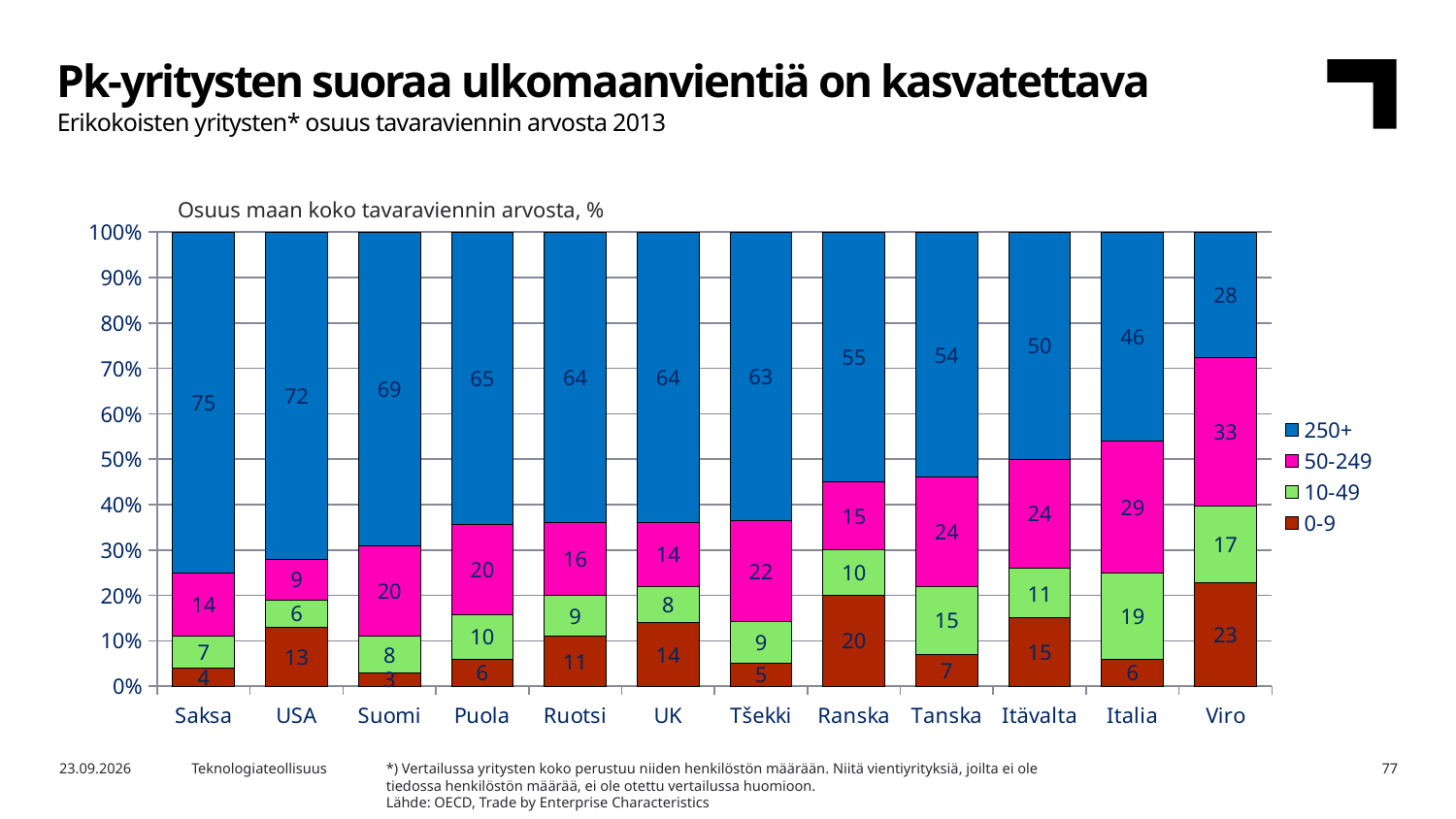
What is the value of the 0-9 series for Viro? 23 What is the value of the 250+ series for Saksa? 75 What is the value of the 10-49 series for Tanska? 15 How many countries are shown on the x axis? 12 Which country has the lowest value for the 0-9 series? Suomi What is the difference between the 250+ values for Saksa and Viro? 47 What is the value of the 50-249 series for Italia? 29 Which country has the highest value for the 250+ series? Saksa What kind of chart is shown on the slide? Stacked bar chart Which is larger, the 50-249 value for Tšekki or for Ruotsi? Tšekki Do the 250+ values rise or fall moving from Saksa to Viro along the x axis? Fall How many series does the legend list? 4